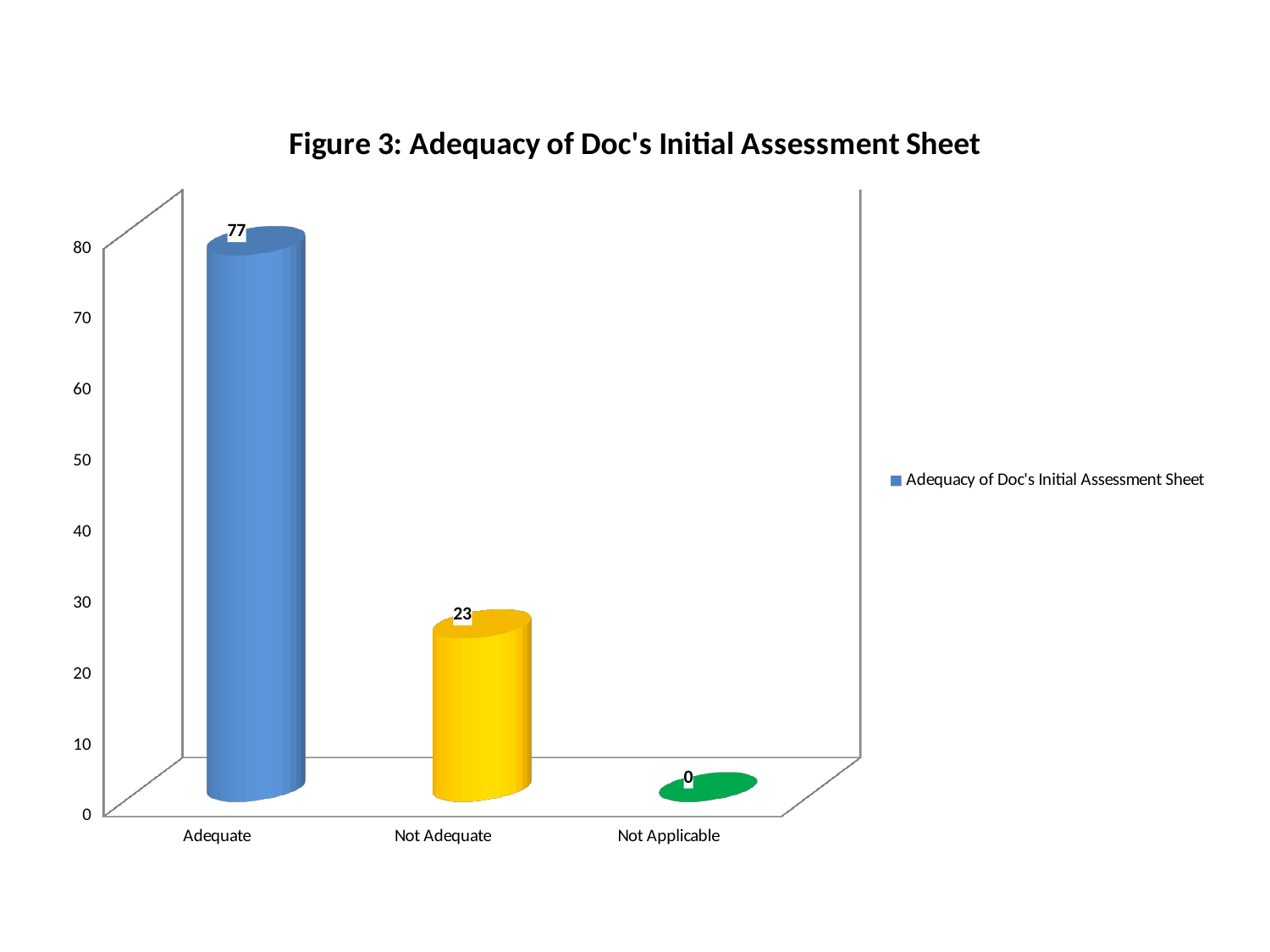
Which category has the lowest value? Not Applicable Is the value for Not Adequate greater or less than 30? less Which category has the highest value? Adequate What is the value for Not Adequate? 23 What is the value for Not Applicable? 0 How many categories are shown on the x axis? 3 How many series does the legend list? 1 What kind of chart is shown? bar chart What is the title of the chart? Figure 3: Adequacy of Doc's Initial Assessment Sheet What is the difference between the values for Adequate and Not Adequate? 54 What is the value for Adequate? 77 Which is larger, the value for Adequate or the value for Not Adequate? Adequate